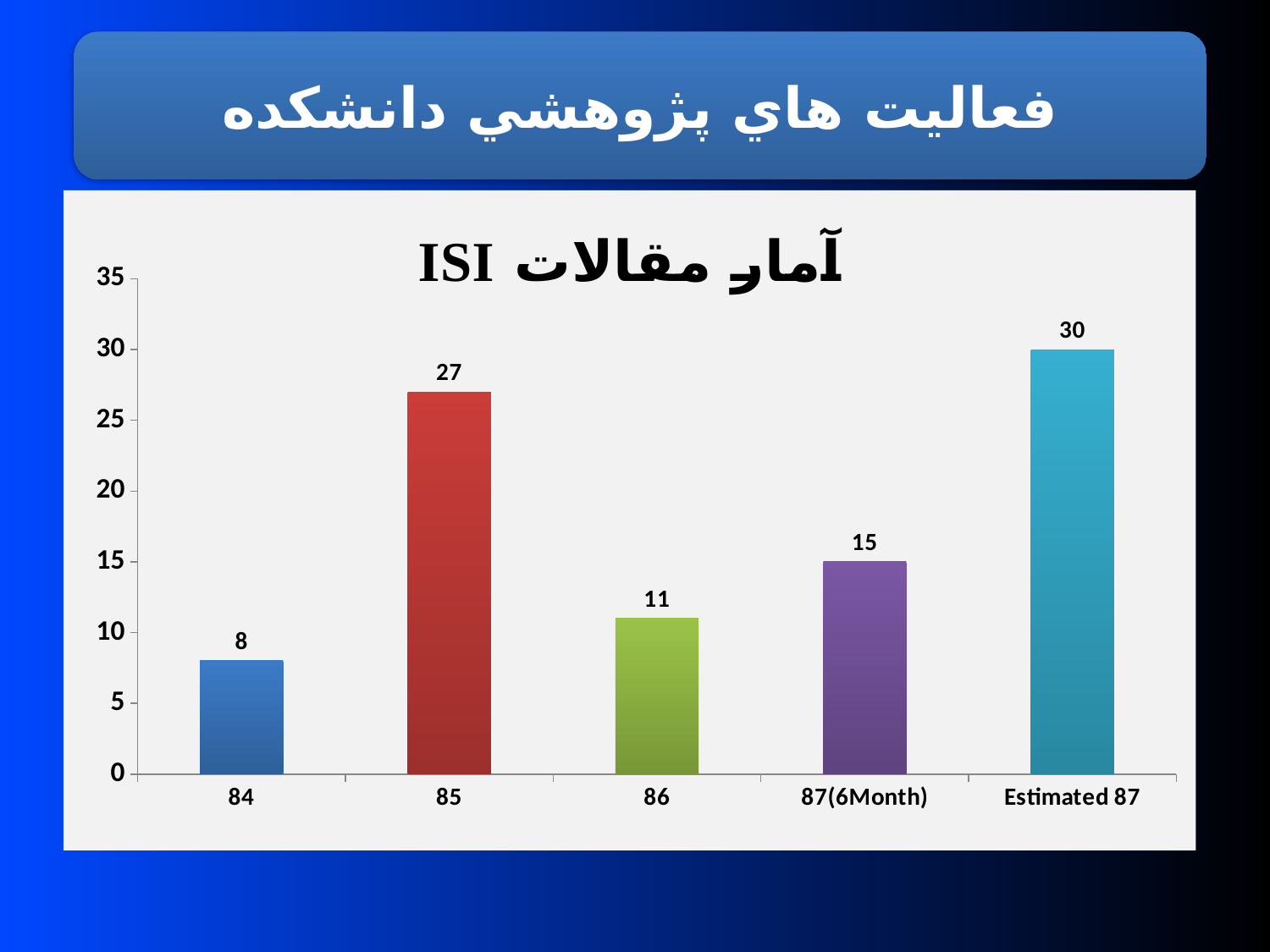
What is the difference between the values for 85 and 86? 16 What kind of chart is shown on the slide? Bar chart What is the value for 86? 11 How many categories are shown on the x axis? 5 Which is larger, the value for 85 or the value for 87(6Month)? 85 What is the value for 85? 27 Which category has the lowest value? 84 What is the difference between the values for Estimated 87 and 84? 22 What is the value for Estimated 87? 30 Which category has the highest value? Estimated 87 What is the value for 87(6Month)? 15 What is the value for 84? 8